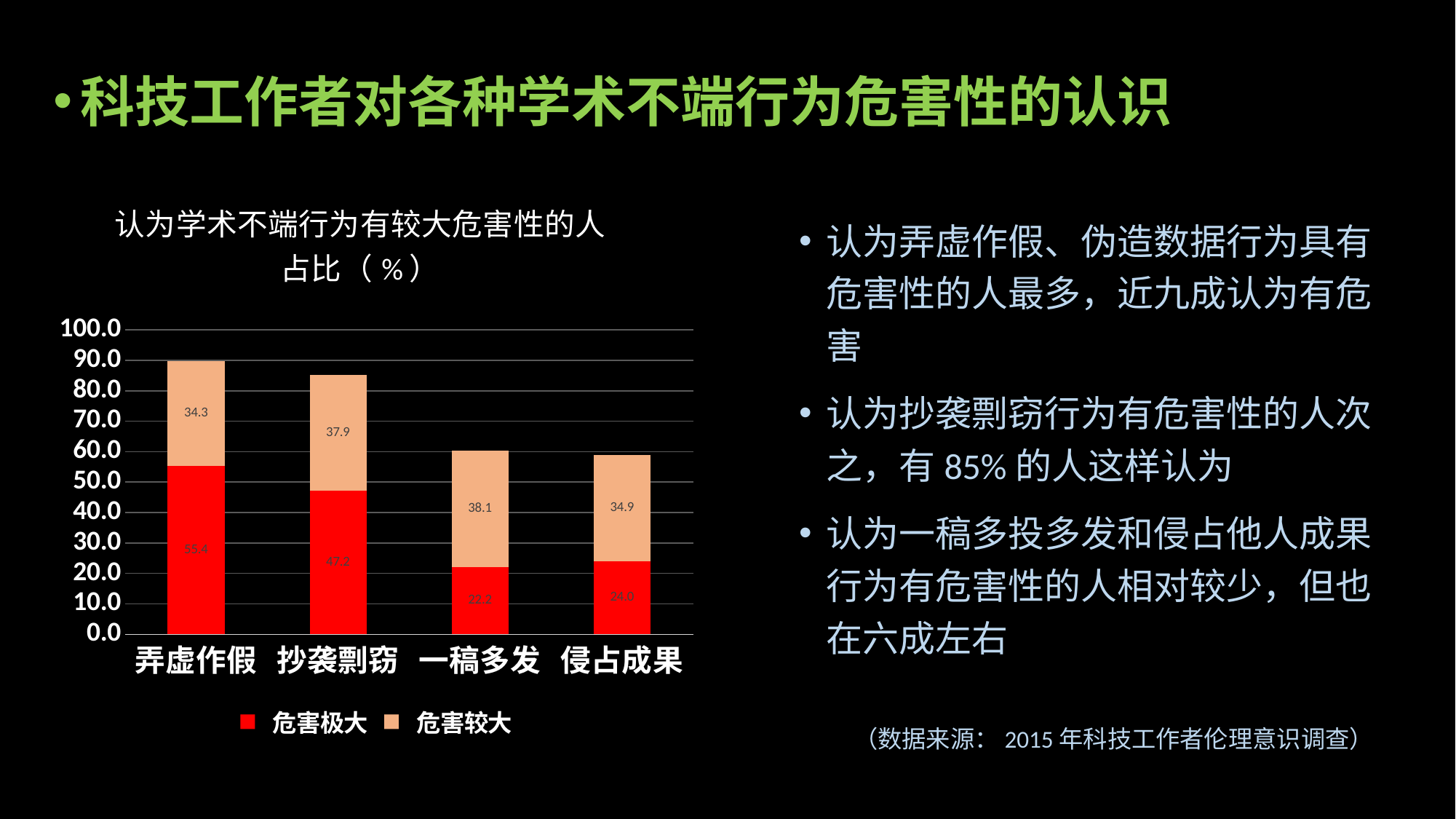
What is the total of the stacked bar for 弄虚作假? 89.7 How many categories are shown on the x axis? 4 How many series does the legend list? 2 What is the value of 危害极大 for 弄虚作假? 55.4 What is the difference between the 危害极大 values for 弄虚作假 and 抄袭剽窃? 8.2 Which category has the highest value for 危害极大? 弄虚作假 Which category has the lowest value for 危害极大? 一稿多发 What is the value of 危害极大 for 一稿多发? 22.2 What kind of chart is shown on the slide? Stacked bar chart Which is larger: the 危害较大 value for 一稿多发 or for 侵占成果? 一稿多发 What is the value of 危害较大 for 侵占成果? 34.9 What is the value of 危害较大 for 抄袭剽窃? 37.9